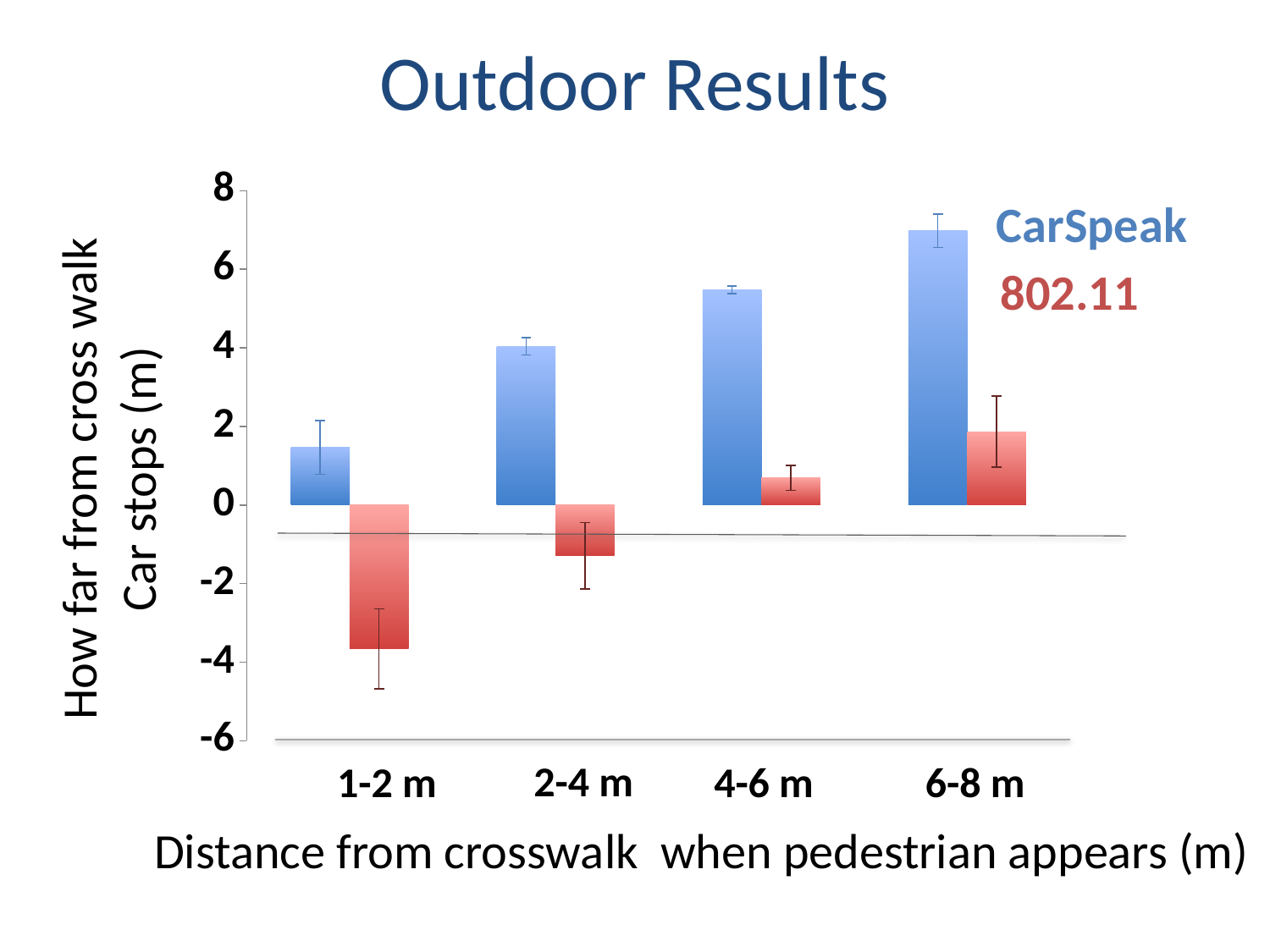
Is the CarSpeak value for 6-8 m greater or less than 6? greater Is the 802.11 value for 2-4 m greater or less than 0? less What is the title of the slide? Outdoor Results How many series does the legend list? 2 For which distance category is the 802.11 value lowest? 1-2 m What kind of chart is shown on the slide? bar chart Do the CarSpeak values rise or fall as the distance from the crosswalk increases? rise How many distance categories are shown on the x axis? 4 For which distance category is the CarSpeak value highest? 6-8 m Is the 802.11 value for 1-2 m greater or less than -2? less At 4-6 m, which series has the larger value, CarSpeak or 802.11? CarSpeak